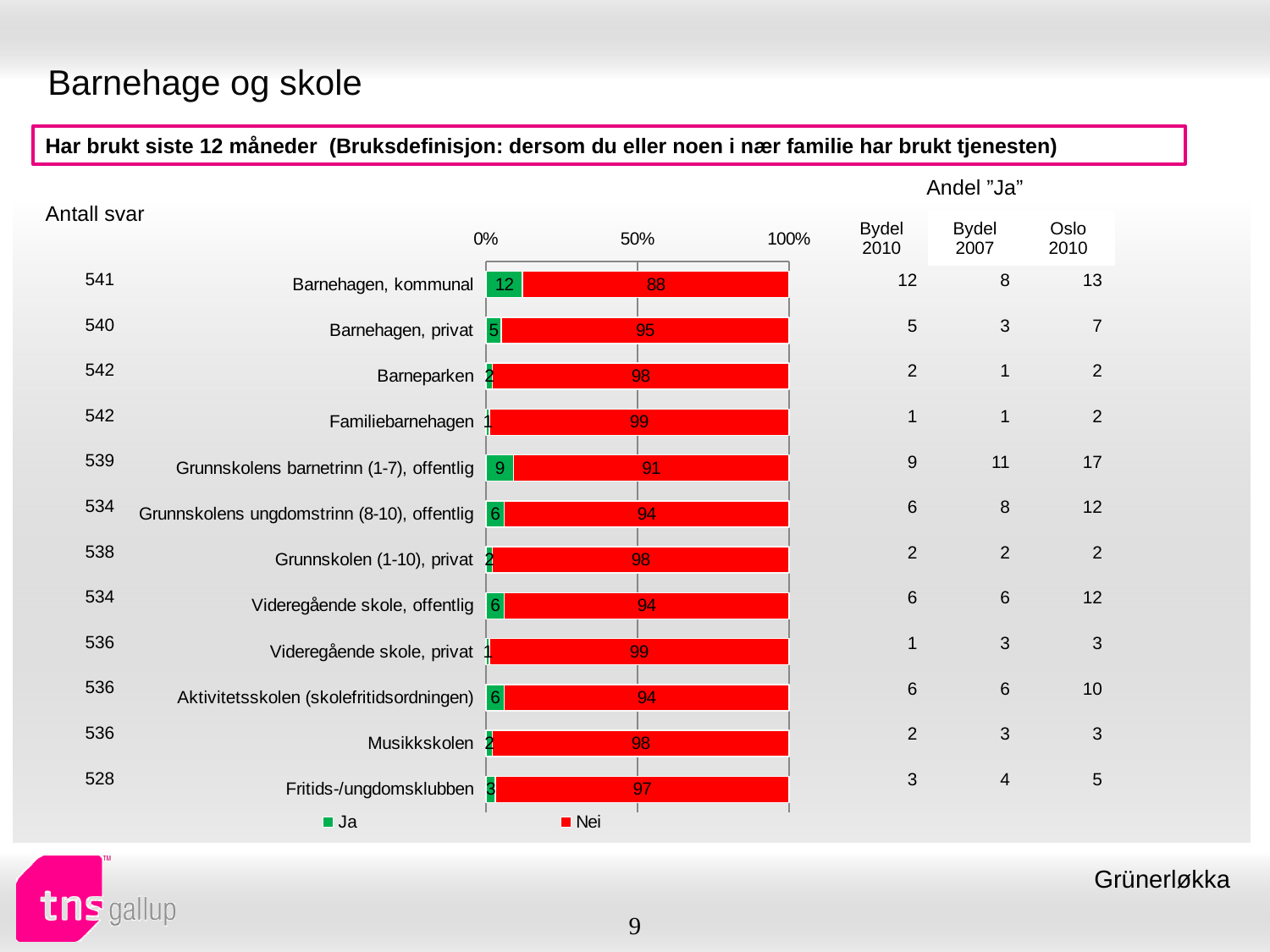
What is the difference between the "Nei" values for Barnehagen, privat and Barnehagen, kommunal? 7 Which category has the lowest "Nei" value? Barnehagen, kommunal How many categories are plotted in the chart? 12 Which is larger, the "Ja" value for Barnehagen, kommunal or for Videregående skole, offentlig? Barnehagen, kommunal What kind of chart is shown on the slide? stacked bar chart Which category has the highest "Ja" value? Barnehagen, kommunal What is the "Ja" value for Grunnskolens barnetrinn (1-7), offentlig? 9 How many series does the chart legend list? 2 What is the "Nei" value for Barnehagen, kommunal? 88 What is the total of the stacked bar for Grunnskolens ungdomstrinn (8-10), offentlig? 100 What colour represents the "Nei" series in the chart? red What is the "Nei" value for Fritids-/ungdomsklubben? 97